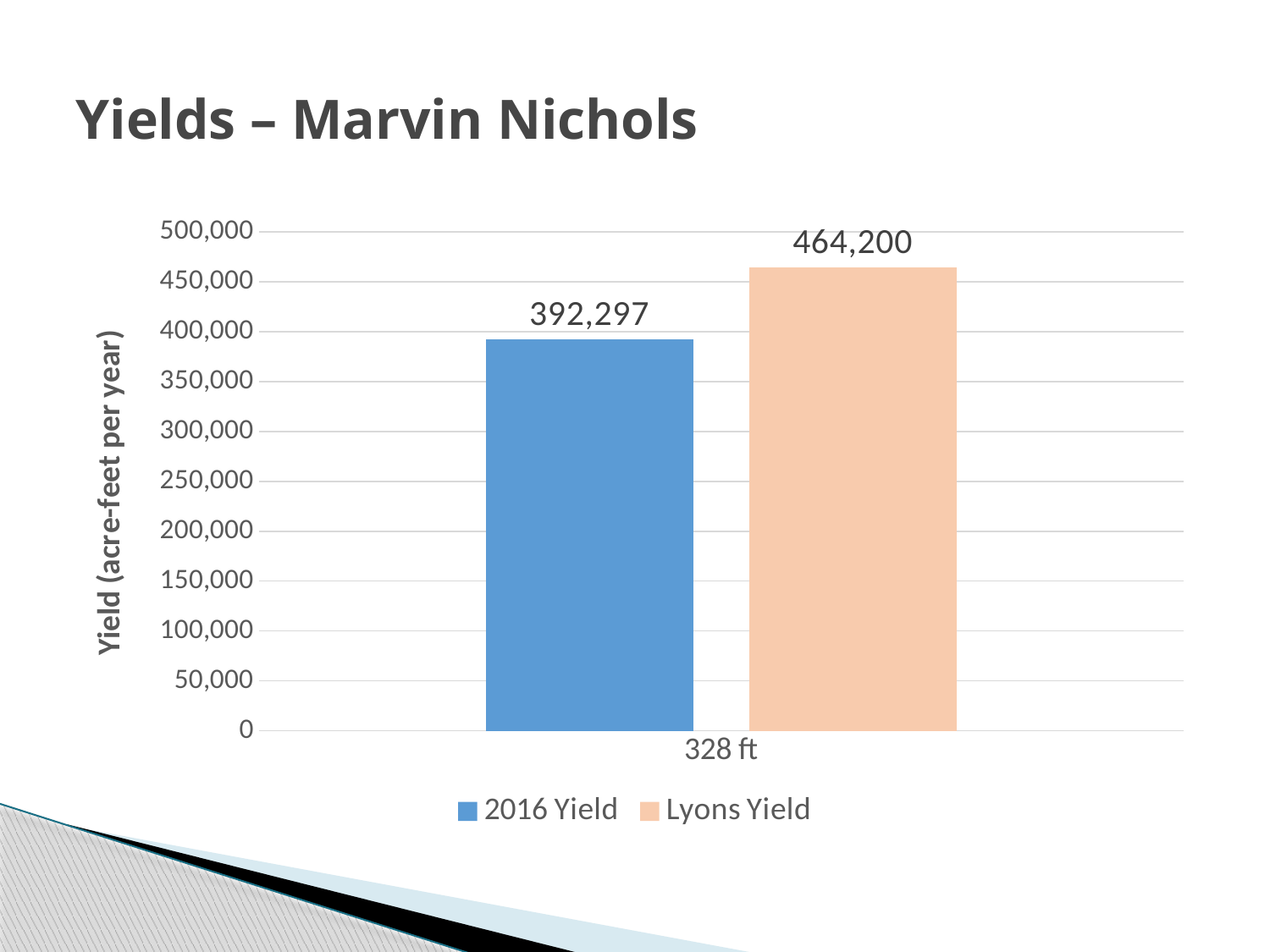
Is the Lyons Yield value greater or less than 450,000? greater How many categories are shown on the x axis? 1 What kind of chart is shown on the slide? bar chart Which series has the higher value at 328 ft, 2016 Yield or Lyons Yield? Lyons Yield What is the difference between the Lyons Yield and the 2016 Yield at 328 ft? 71,903 What is the 2016 Yield value for 328 ft? 392,297 What colour is the bar for Lyons Yield? light orange What is the label on the y axis? Yield (acre-feet per year) How many series does the legend list? 2 Which series has the lowest value on the chart? 2016 Yield Is the 2016 Yield value greater or less than 400,000? less What is the Lyons Yield value for 328 ft? 464,200